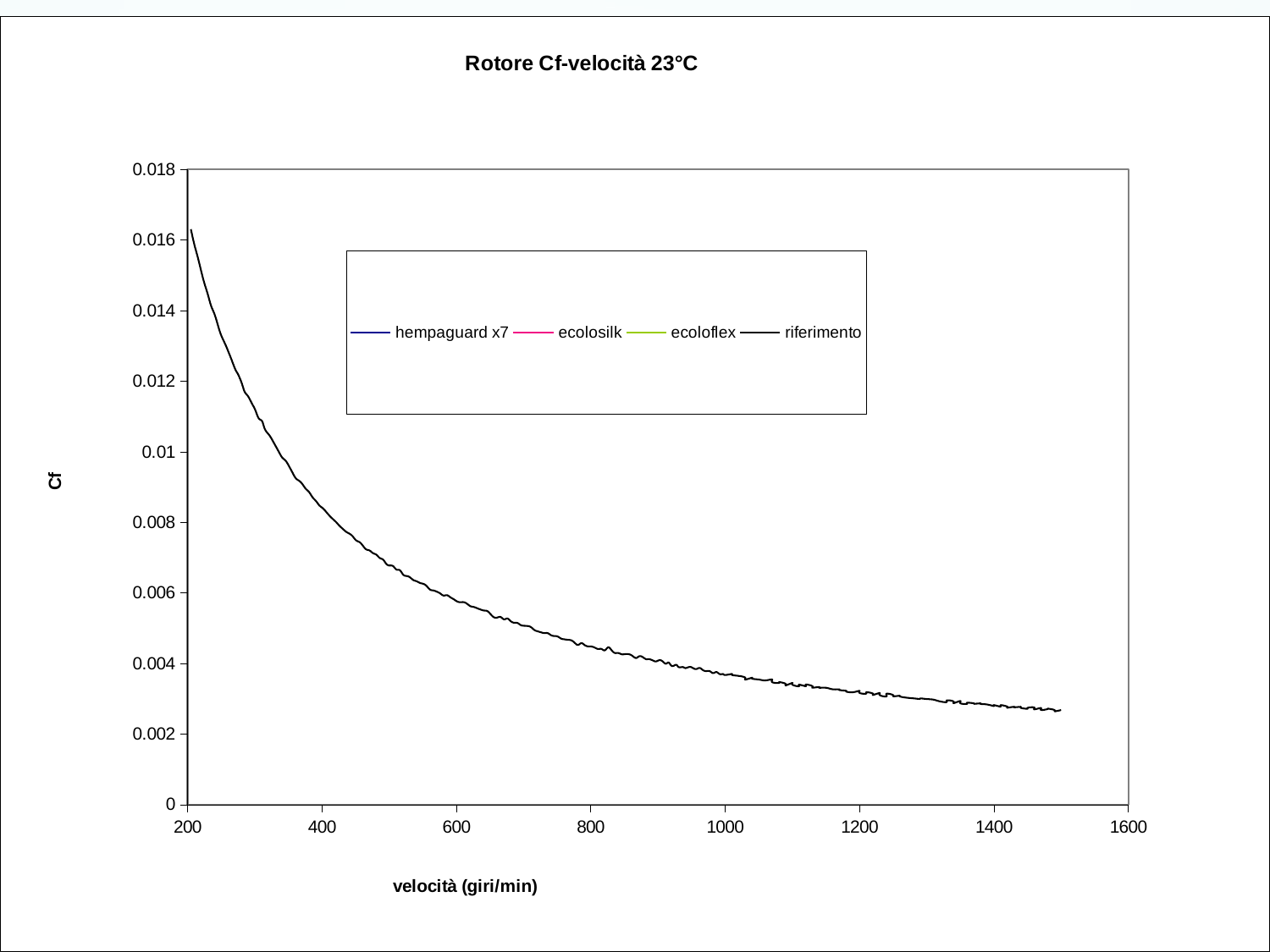
How many series does the legend list? 4 Which is larger for the riferimento line: the Cf value at 400 giri/min or at 1200 giri/min? 400 giri/min Is the Cf value of the riferimento line at 800 giri/min greater or less than 0.004? greater Is the Cf value of the riferimento line at 200 giri/min greater or less than 0.014? greater Does the riferimento line rise or fall as velocità increases? fall Is the Cf value of the riferimento line at 400 giri/min greater or less than 0.008? greater What kind of chart is shown on the slide? line chart What is the label of the x axis? velocità (giri/min) What is the title of the chart? Rotore Cf-velocità 23°C